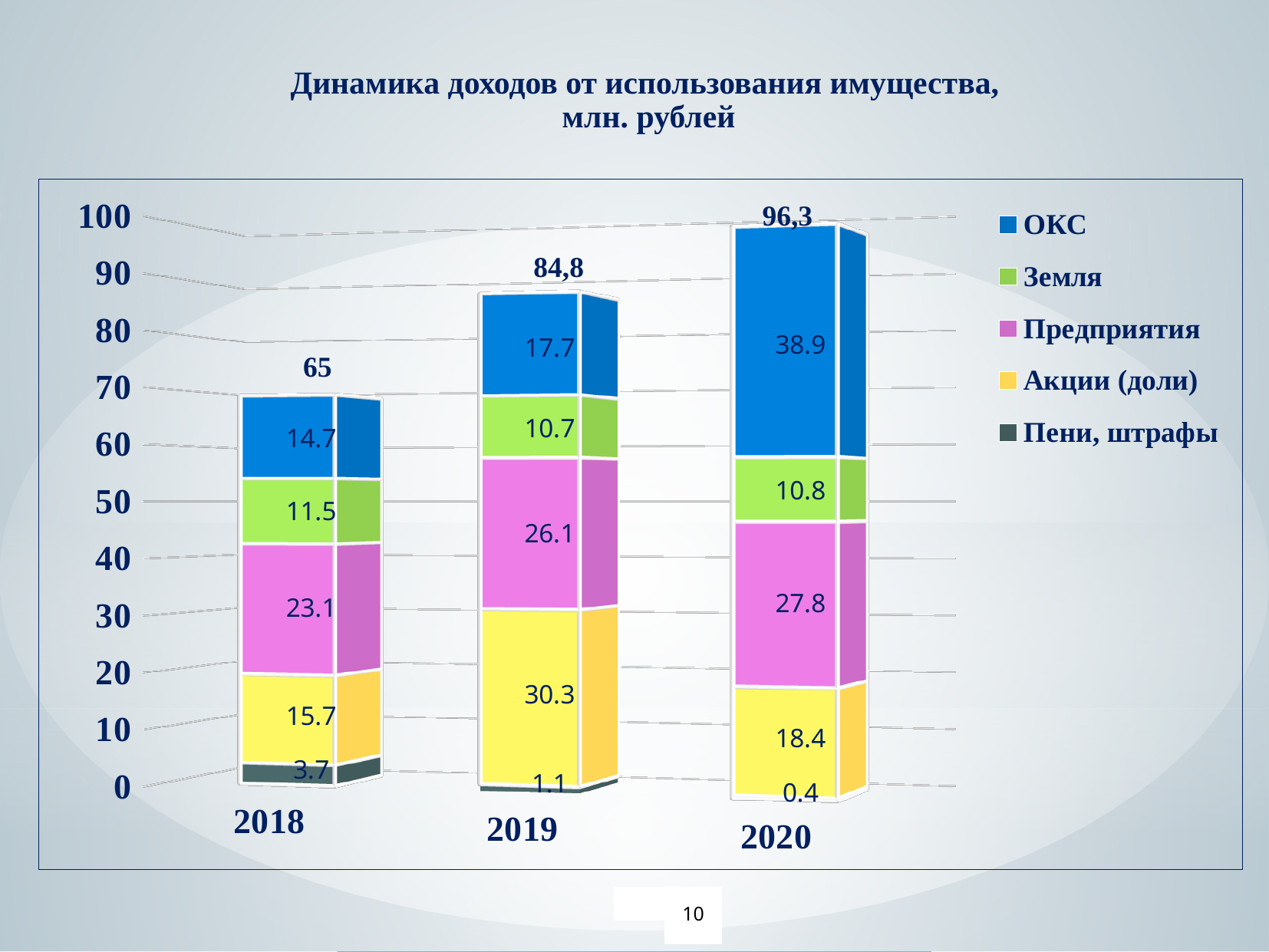
Which year has the highest total income? 2020 What kind of chart is shown on the slide? Stacked bar chart Which year has the lowest value for Пени, штрафы? 2020 What is the total of the stacked bar for 2019? 84,8 How many years are shown on the x axis? 3 What is the value for ОКС in 2020? 38.9 What is the difference between the ОКС values for 2020 and 2019? 21.2 What is the value for Пени, штрафы in 2018? 3.7 Do the total values rise or fall from 2018 to 2020? Rise What is the value for Акции (доли) in 2019? 30.3 Which is larger, the Предприятия value in 2019 or in 2020? 2020 How many series does the legend list? 5